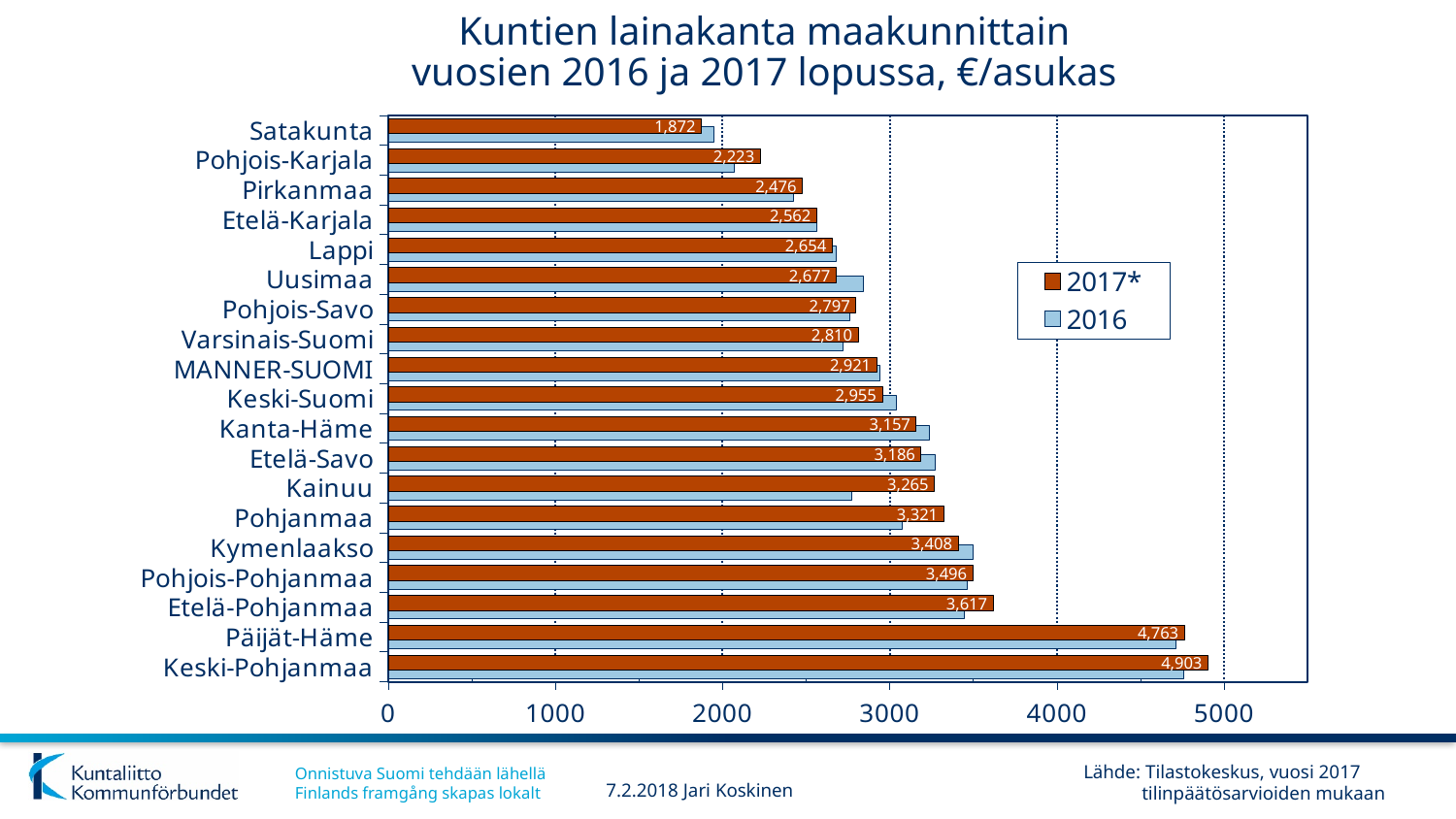
Is the 2016 value for Satakunta greater or less than 2000? less What is the difference between the 2017* values for Keski-Pohjanmaa and Päijät-Häme? 140 What is the 2017* value for MANNER-SUOMI? 2,921 Which has a larger 2017* value, Kainuu or Pohjanmaa? Pohjanmaa What is the 2017* value for Satakunta? 1,872 Is the 2016 value for Keski-Pohjanmaa greater or less than 4000? greater What is the 2017* value for Uusimaa? 2,677 Which region has the highest 2017* value? Keski-Pohjanmaa How many series does the legend list? 2 How many regions are shown on the chart? 19 What kind of chart is shown on the slide? bar chart Which region has the lowest 2017* value? Satakunta